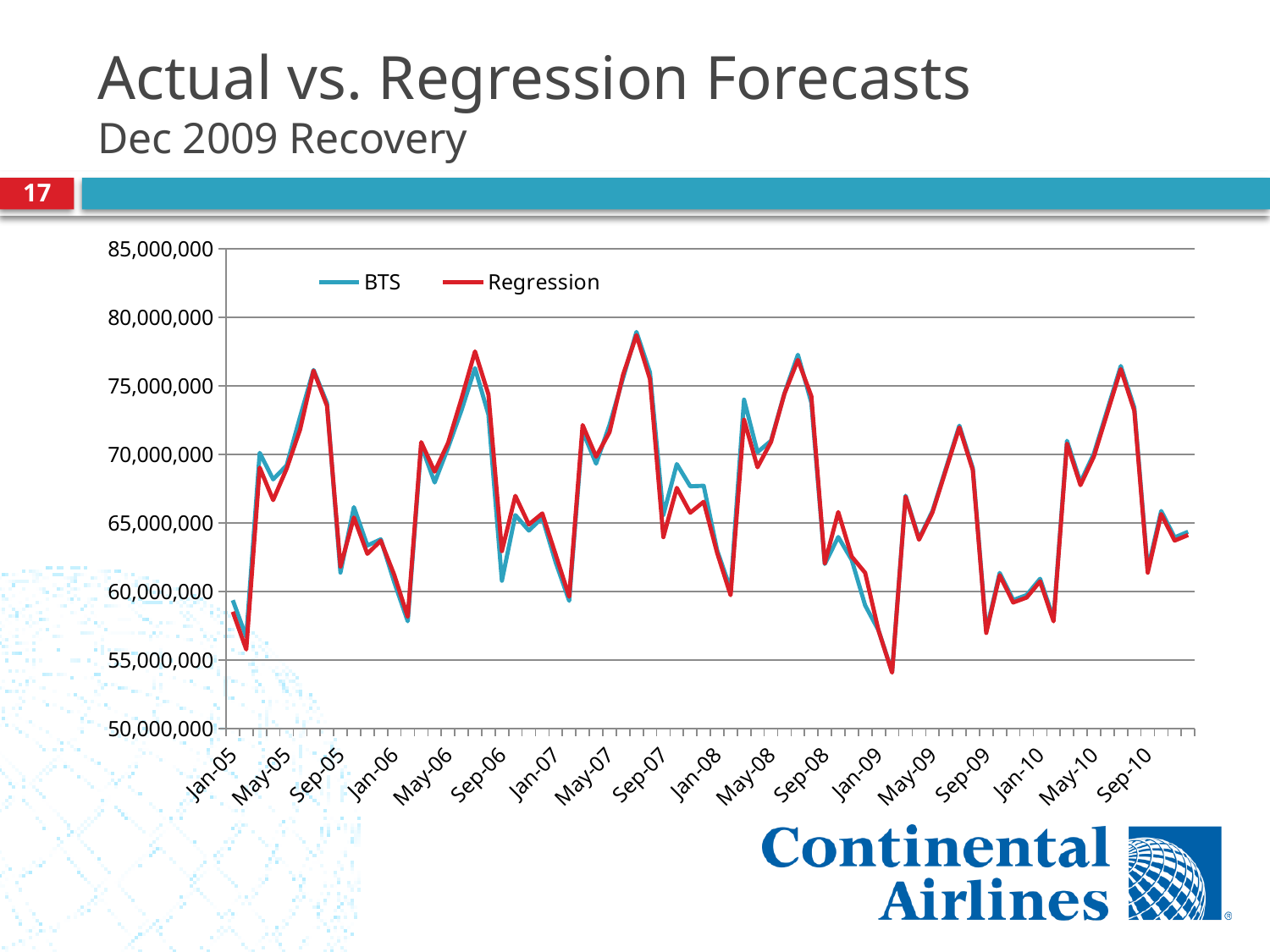
Is the lowest point on the chart greater or less than 55,000,000? less Which of the two series reaches a higher value at Sep-06, BTS or Regression? Regression What colour is the Regression line? red Is the BTS value for Sep-07 greater or less than 75,000,000? less Is the highest point on the chart greater or less than 75,000,000? greater How many series does the legend list? 2 How many month labels are shown along the x axis? 18 What is the lowest value shown on the vertical axis? 50,000,000 What kind of chart is shown on the slide? line chart What are the two series named in the legend? BTS and Regression